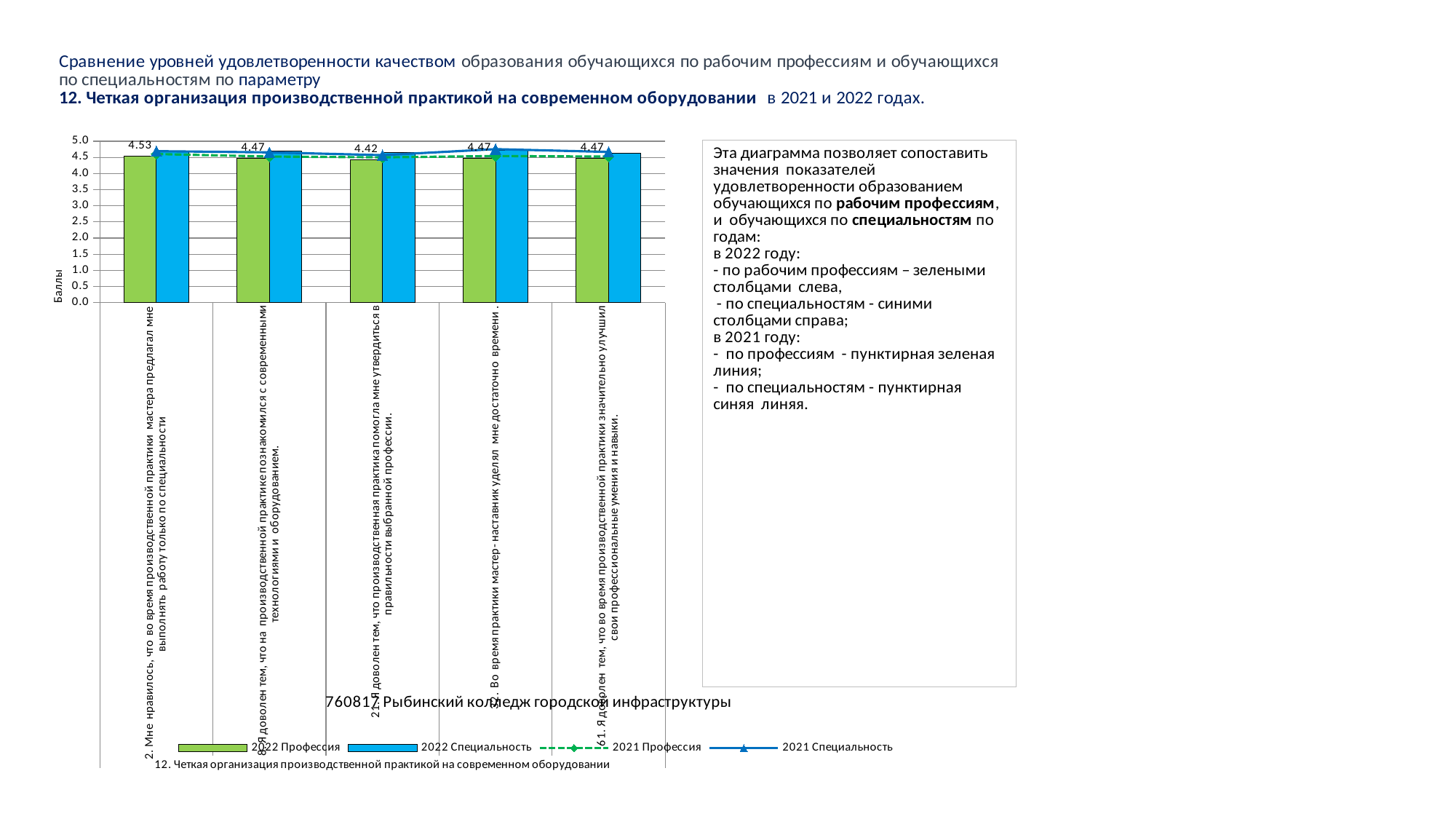
How many categories are shown on the x axis of the chart? 5 What is the 2022 Профессия value for category 2 (Мне нравилось, что во время производственной практики мастера предлагал мне выполнять работу только по специальности)? 4.53 What is the 2022 Профессия value for category 27 (Я доволен тем, что производственная практика помогла мне утвердиться в правильности выбранной профессии)? 4.42 What is the 2022 Профессия value for category 8 (Я доволен тем, что на производственной практике познакомился с современными технологиями и оборудованием)? 4.47 Which category has the lowest labelled 2022 Профессия value? 21. Я доволен тем, что производственная практика помогла мне утвердиться в правильности выбранной профессии How many series does the legend list? 4 What is the label of the vertical axis? Баллы Is the 2022 Специальность value for category 61 greater or less than 4.0? greater Which category has the highest labelled 2022 Профессия value? 2. Мне нравилось, что во время производственной практики мастера предлагал мне выполнять работу только по специальности What kind of chart is shown on the slide? Bar chart with line series